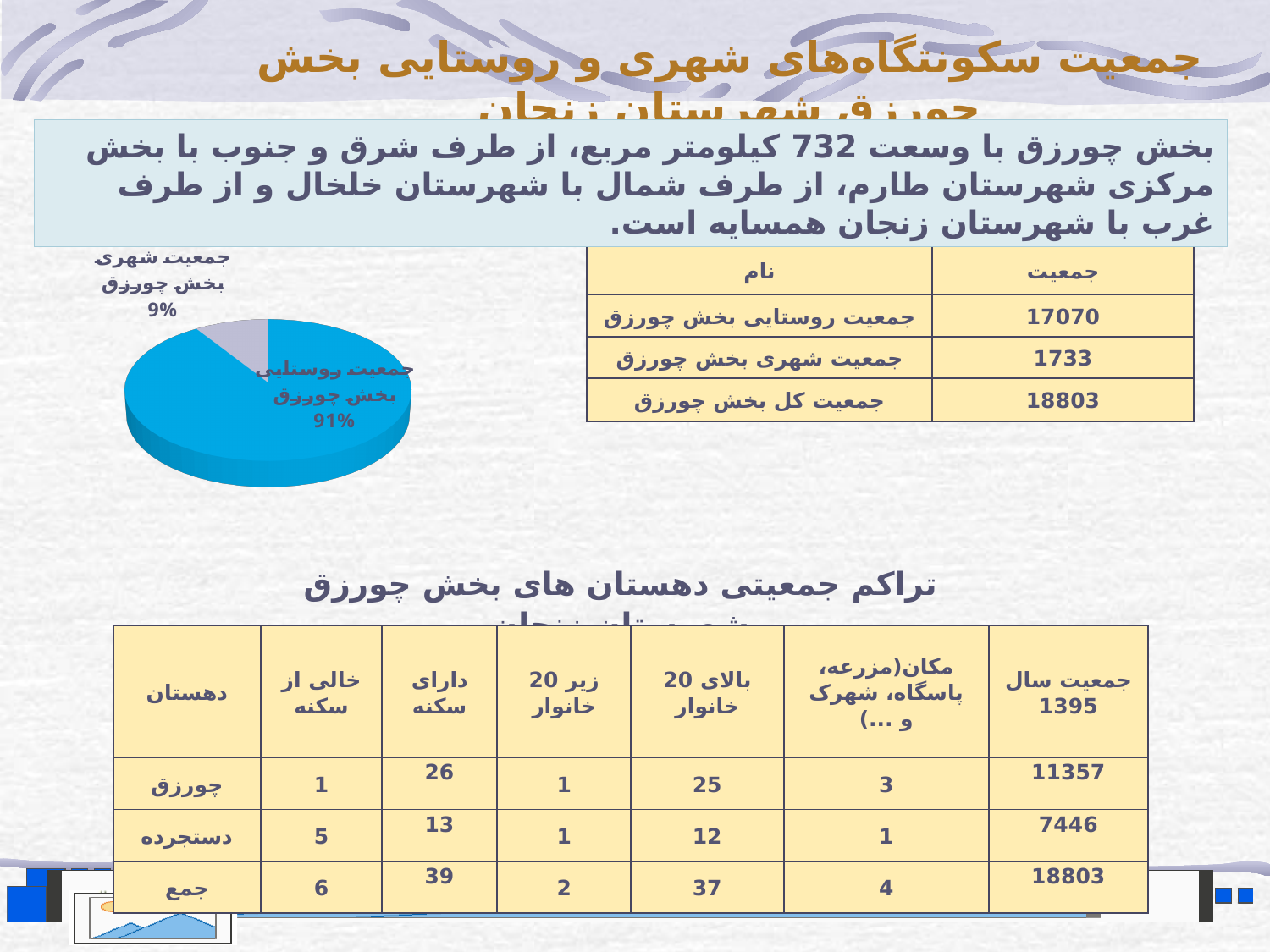
What kind of chart is shown on the slide? pie chart What colour is the slice labelled 9% in the pie chart? light grey Which slice of the pie chart is the largest? جمعیت روستایی بخش چورزق (rural population) What share of the pie does the slice labelled "جمعیت روستایی بخش چورزق" (rural population of Chavarzaq district) take? 91% What share of the pie does the slice labelled "جمعیت شهری بخش چورزق" (urban population of Chavarzaq district) take? 9% How many slices does the pie chart have? 2 Which slice of the pie chart is the smallest? جمعیت شهری بخش چورزق (urban population) By how many percentage points does the rural population slice exceed the urban population slice in the pie chart? 82 percentage points What colour is the largest slice of the pie chart? blue In the pie chart, which is larger: the rural population share or the urban population share? rural population share